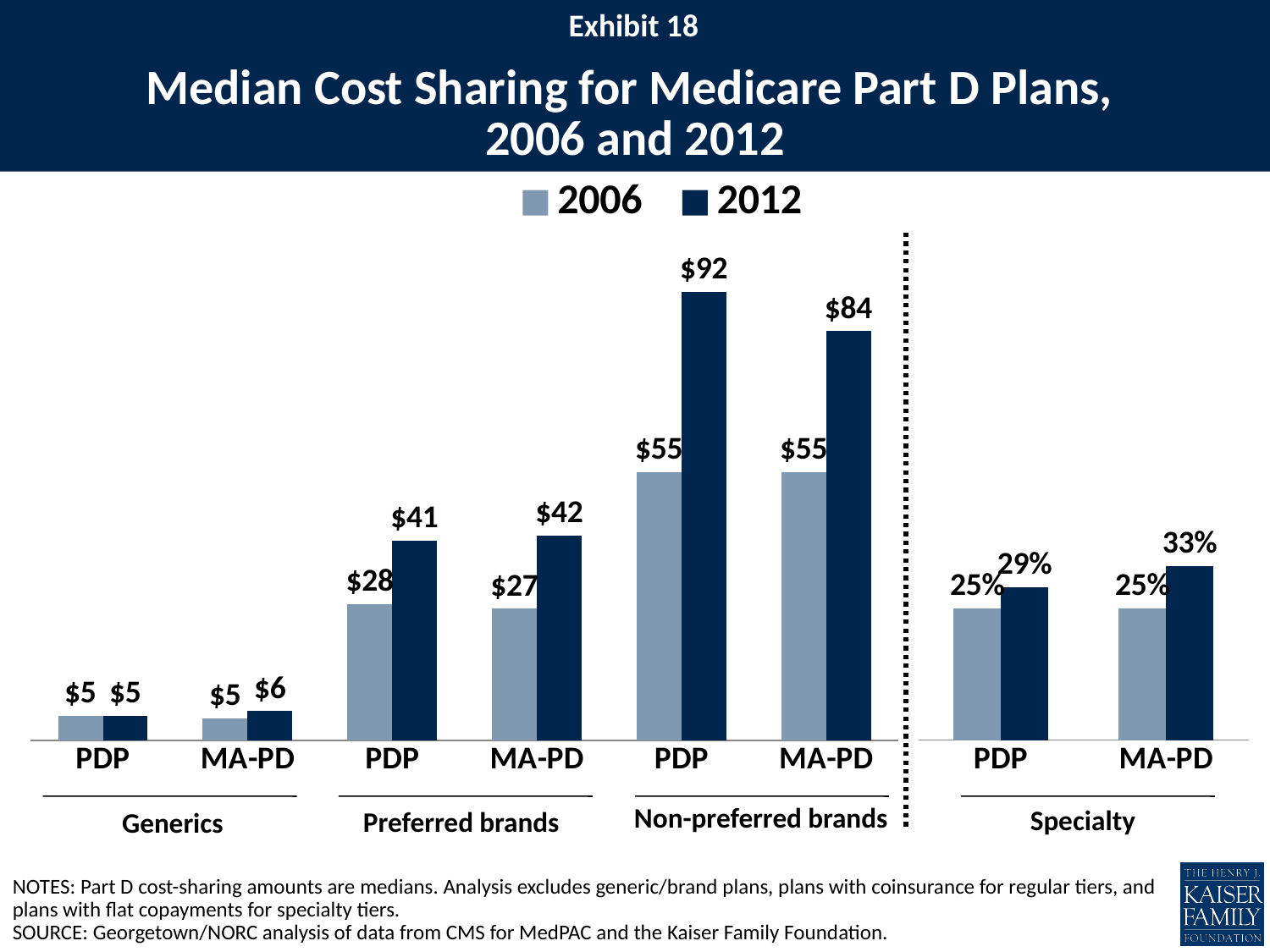
What kind of chart is shown on the slide? Bar chart What is the 2006 median cost sharing for MA-PD plans in the Preferred brands tier? $27 What is the 2006 value for PDP plans in the Generics tier? $5 Which is larger: the 2012 value for PDP or for MA-PD in the Non-preferred brands tier? PDP How many series does the legend list? 2 What is the 2012 value for MA-PD plans in the Specialty tier? 33% What is the difference between the 2012 and 2006 values for MA-PD plans in the Preferred brands tier? $15 Which series is shown in the darker navy colour? 2012 Which tier and plan type has the highest 2012 dollar value shown? Non-preferred brands, PDP What is the 2012 median cost sharing for PDP plans in the Non-preferred brands tier? $92 Which is larger: the 2012 value for PDP or for MA-PD in the Specialty tier? MA-PD What is the difference between the 2012 and 2006 values for PDP plans in the Non-preferred brands tier? $37